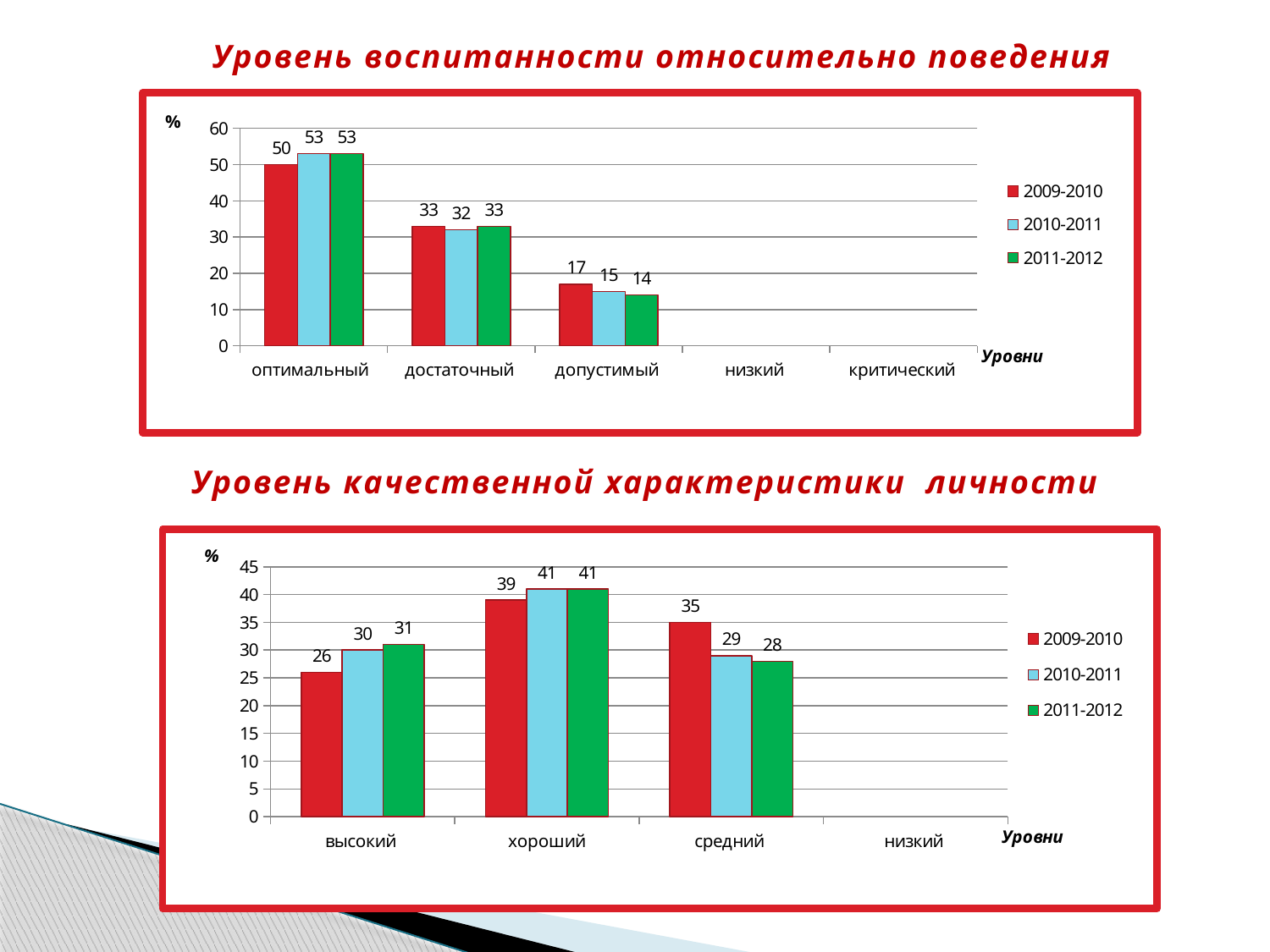
In the top chart (Уровень воспитанности относительно поведения), what is the value for оптимальный in 2009-2010? 50 In the top chart (Уровень воспитанности относительно поведения), how many categories are shown on the x axis? 5 What kind of chart is the bottom chart (Уровень качественной характеристики личности)? bar chart In the bottom chart (Уровень качественной характеристики личности), what is the value for средний in 2009-2010? 35 In the bottom chart (Уровень качественной характеристики личности), what is the value for высокий in 2010-2011? 30 In the top chart (Уровень воспитанности относительно поведения), which category has the highest value for 2010-2011? оптимальный In the bottom chart (Уровень качественной характеристики личности), which category has the lowest value for 2011-2012 among those with bars? средний In the top chart (Уровень воспитанности относительно поведения), how many series does the legend list? 3 In the top chart (Уровень воспитанности относительно поведения), what is the value for допустимый in 2011-2012? 14 In the bottom chart (Уровень качественной характеристики личности), which is larger for хороший: the 2009-2010 value or the 2011-2012 value? 2011-2012 In the bottom chart (Уровень качественной характеристики личности), what is the difference between the 2009-2010 and 2011-2012 values for средний? 7 In the top chart (Уровень воспитанности относительно поведения), what is the difference between the 2011-2012 values for оптимальный and достаточный? 20